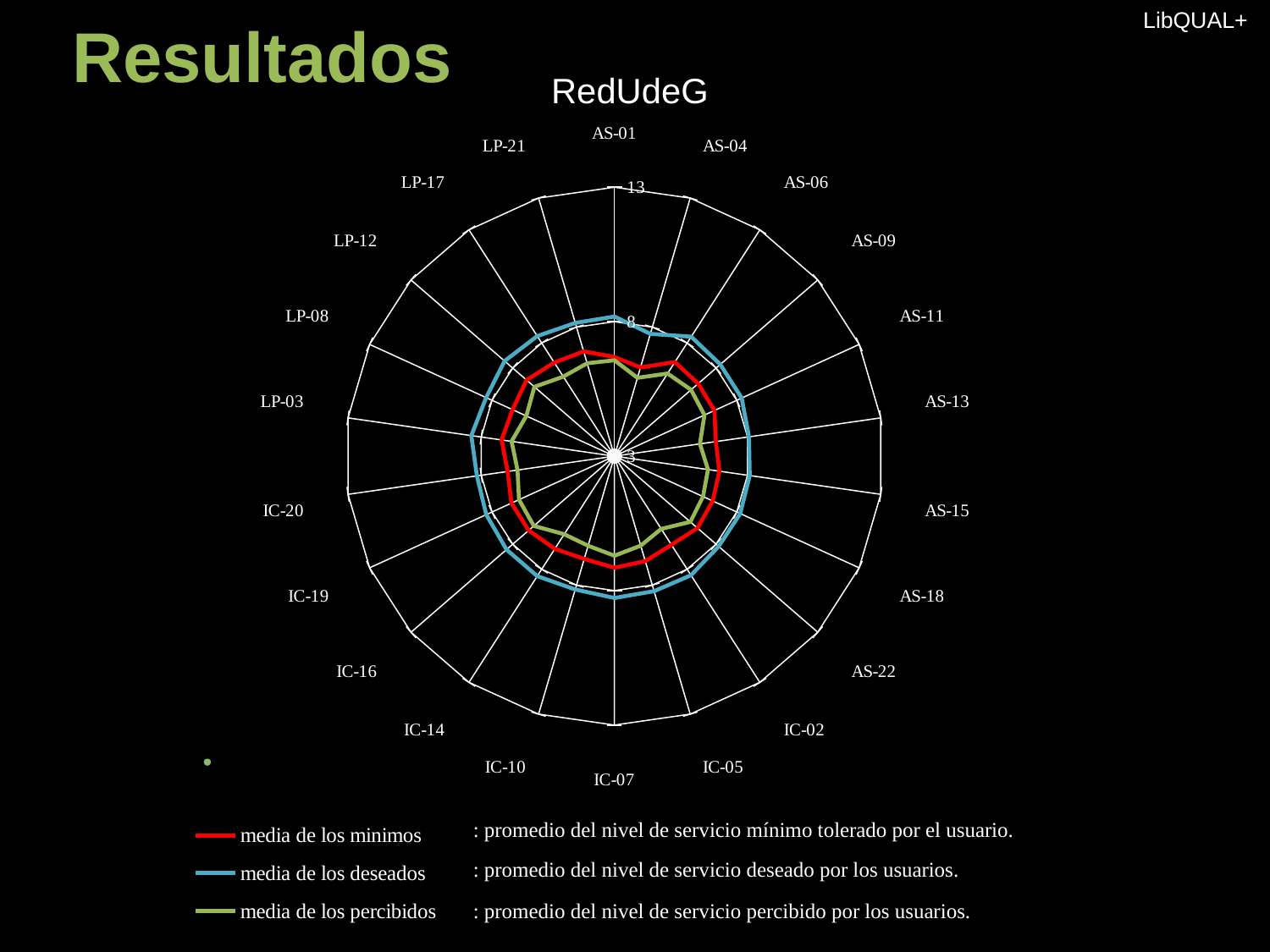
Which series lies outermost on the radar chart across all categories? media de los deseados At AS-13, which series has the larger value: media de los deseados or media de los percibidos? media de los deseados Is the value of media de los minimos at IC-07 greater or less than 8? less What is the title of the chart? RedUdeG Is the value of media de los percibidos at AS-01 greater or less than 8? less What kind of chart is shown on the slide? radar chart At LP-03, which series has the larger value: media de los deseados or media de los minimos? media de los deseados How many categories (axes) does the radar chart have? 22 How many series does the legend list? 3 At IC-07, which series has the larger value: media de los minimos or media de los percibidos? media de los minimos Is the value of media de los percibidos at LP-03 greater or less than 8? less Which colour represents 'media de los deseados' in the chart? blue